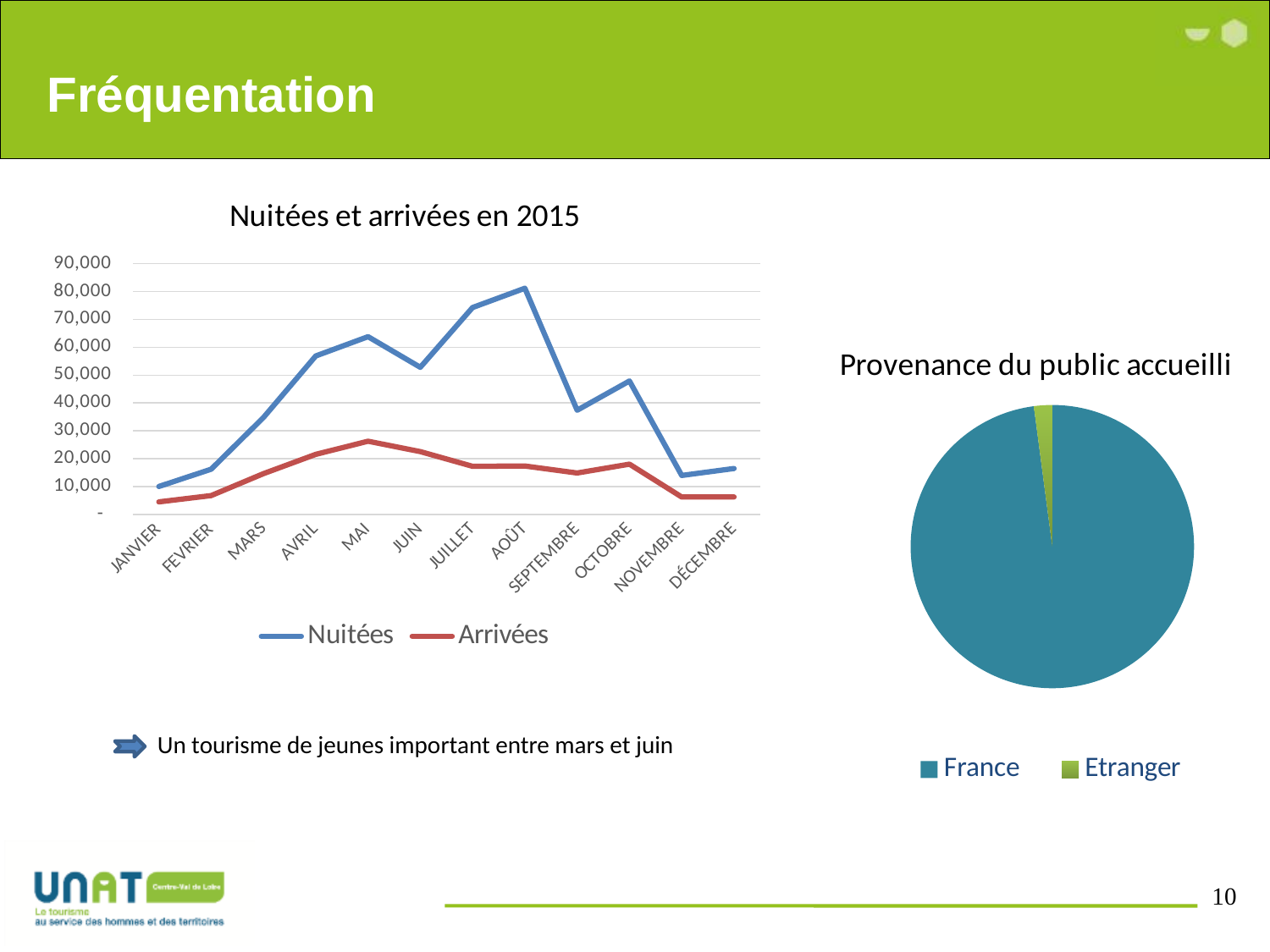
On the chart titled 'Nuitées et arrivées en 2015', what kind of chart is it? line chart On the chart titled 'Nuitées et arrivées en 2015', do the Nuitées values rise or fall from JANVIER to MAI? rise On the chart titled 'Provenance du public accueilli', what kind of chart is it? pie chart On the chart titled 'Nuitées et arrivées en 2015', in which month is the Arrivées value highest? MAI On the chart titled 'Nuitées et arrivées en 2015', how many series does the legend list? 2 On the chart titled 'Provenance du public accueilli', which slice is larger, France or Etranger? France On the chart titled 'Nuitées et arrivées en 2015', in which month is the Nuitées value highest? AOÛT On the chart titled 'Nuitées et arrivées en 2015', is the Nuitées value for SEPTEMBRE greater or less than 40,000? less On the chart titled 'Nuitées et arrivées en 2015', is the Nuitées value for AOÛT greater or less than 70,000? greater On the chart titled 'Nuitées et arrivées en 2015', how many months are shown on the x axis? 12 On the chart titled 'Nuitées et arrivées en 2015', is the Arrivées value for MAI greater or less than 20,000? greater On the chart titled 'Nuitées et arrivées en 2015', in which month is the Nuitées value lowest? JANVIER